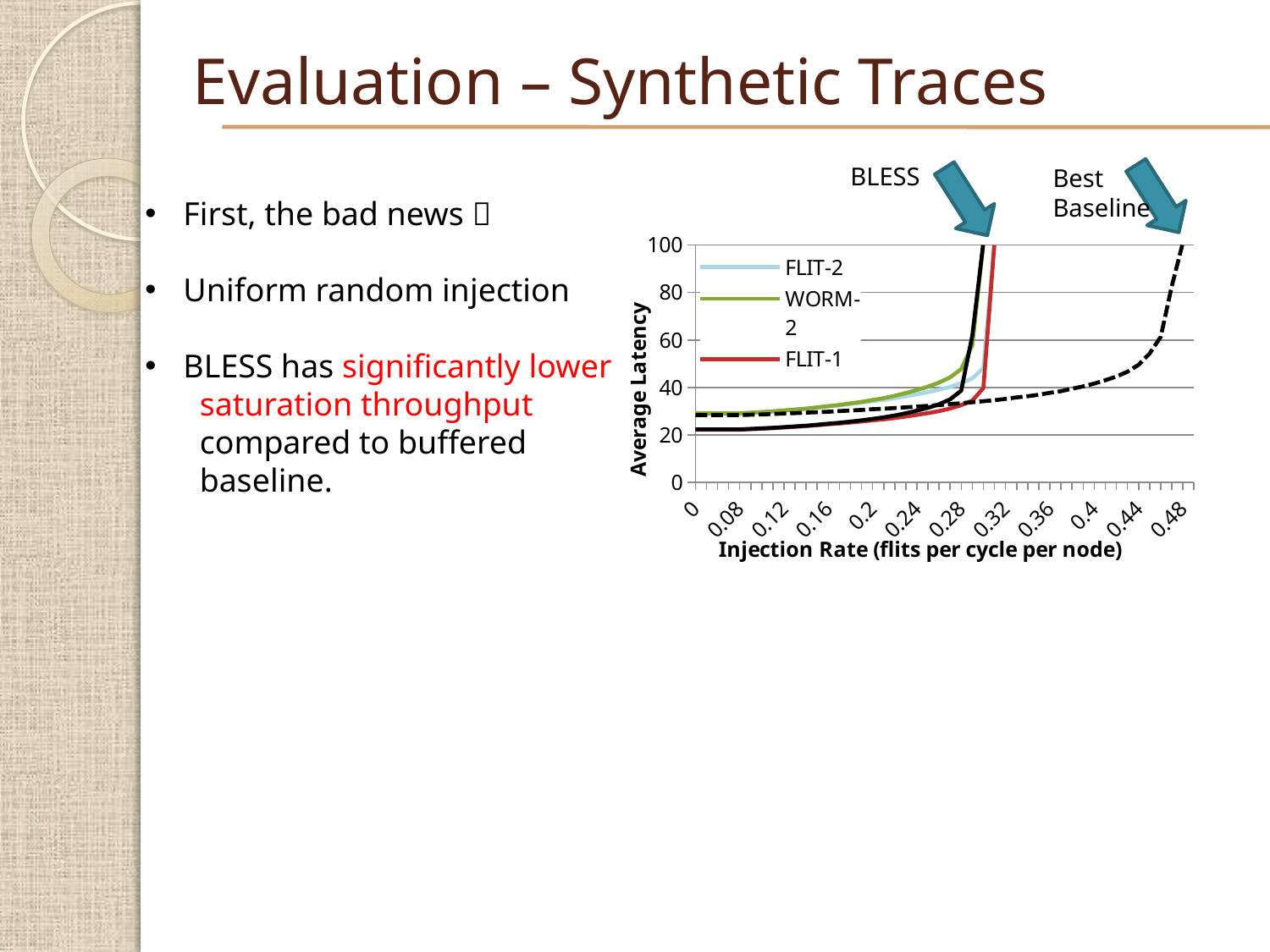
Does the average latency rise or fall as the injection rate increases along the x axis? rise Is the value for FLIT-2 at injection rate 0.12 greater or less than 60? less At injection rate 0.08, which is larger, the value for WORM-2 or the value for FLIT-1? WORM-2 How many series does the chart's legend list? 3 What is the title of the chart's y axis? Average Latency Is the value for WORM-2 at injection rate 0.2 greater or less than 60? less Is the value for the Best Baseline (dashed line) at injection rate 0.2 greater or less than 60? less What is the title of the chart's x axis? Injection Rate (flits per cycle per node) What kind of chart is shown on the slide? line chart What is the highest value shown on the y axis of the chart? 100